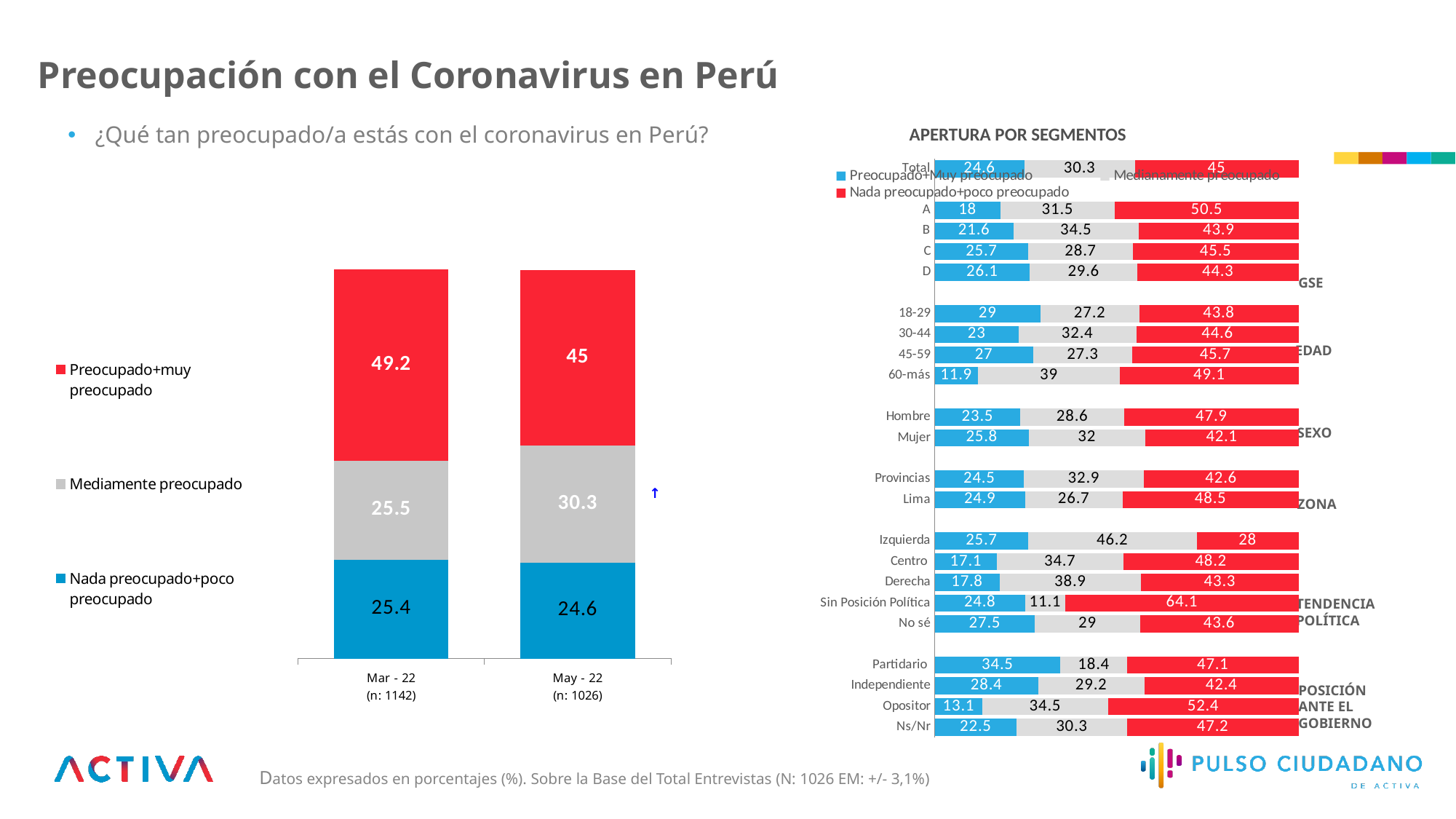
In the APERTURA POR SEGMENTOS chart, which segment row has the lowest blue value? 60-más In the APERTURA POR SEGMENTOS chart, which segment row has the highest blue value? Partidario In the left stacked bar chart, what is the value of the red segment (Preocupado+muy preocupado) for Mar - 22? 49.2 In the APERTURA POR SEGMENTOS chart, which segment row has the lowest red value? Izquierda In the left stacked bar chart, which period has the larger blue segment (Nada preocupado+poco preocupado), Mar - 22 or May - 22? Mar - 22 In the APERTURA POR SEGMENTOS chart, what is the grey segment value for 60-más? 39 In the APERTURA POR SEGMENTOS chart, what is the red segment value for Sin Posición Política? 64.1 What kind of chart is the left chart on the slide? Stacked bar chart In the APERTURA POR SEGMENTOS chart, what is the difference between the red values for Lima and Provincias? 5.9 How many series does the legend of the left stacked bar chart list? 3 In the left stacked bar chart, what is the value of the grey segment (Mediamente preocupado) for May - 22? 30.3 In the left stacked bar chart, what is the difference between the red segment values for Mar - 22 and May - 22? 4.2